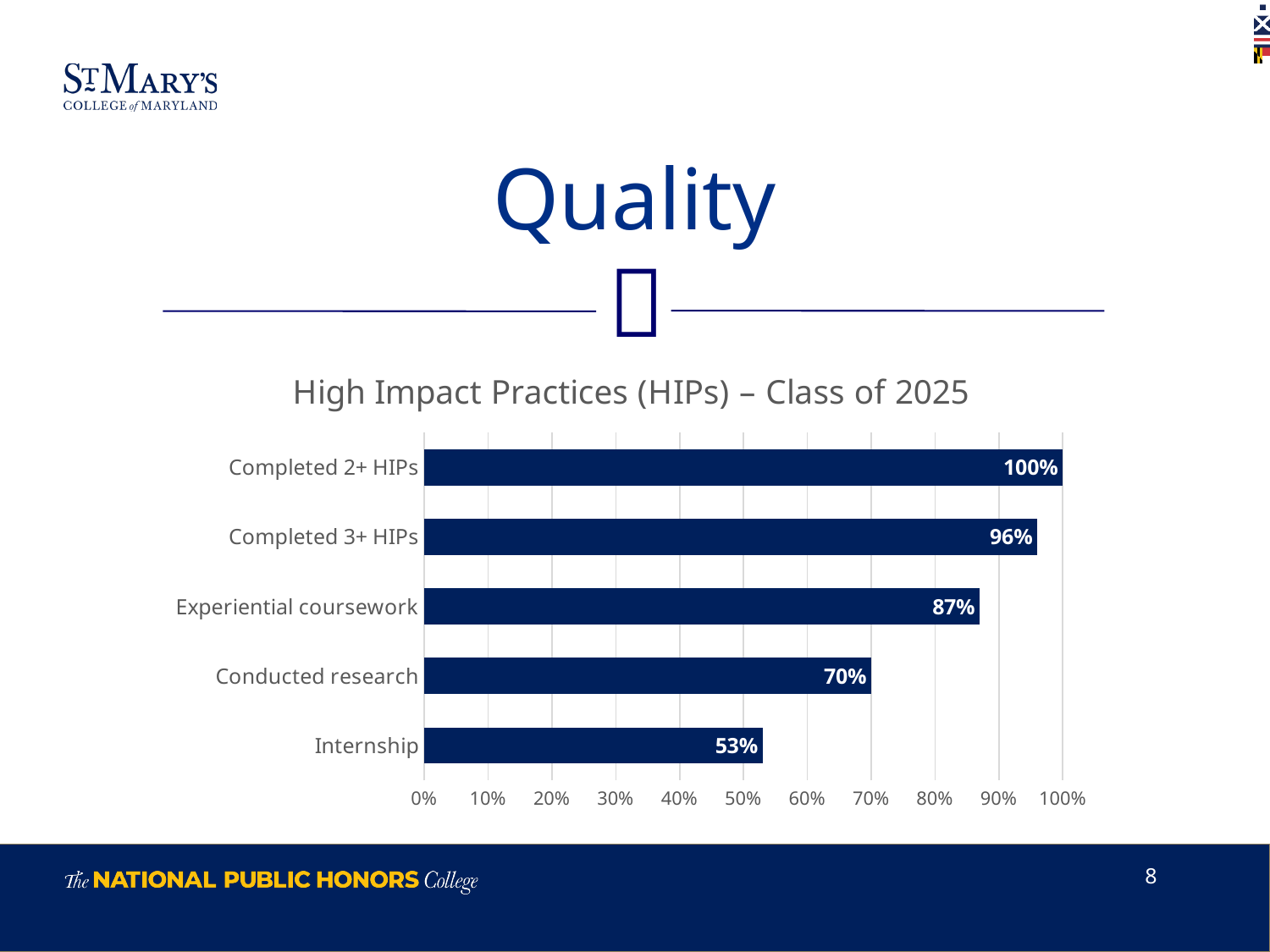
Which is larger, Conducted research or Internship? Conducted research How many categories are shown in the chart? 5 What is the difference between Experiential coursework and Internship? 34% What is the difference between Completed 2+ HIPs and Completed 3+ HIPs? 4% What percentage of the Class of 2025 completed 2+ HIPs? 100% What is the value for Internship? 53% What kind of chart is shown on the slide? Bar chart What is the value for Experiential coursework? 87% What is the value for Conducted research? 70% Which category has the highest value? Completed 2+ HIPs Which category has the lowest value? Internship What is the title of the chart? High Impact Practices (HIPs) – Class of 2025